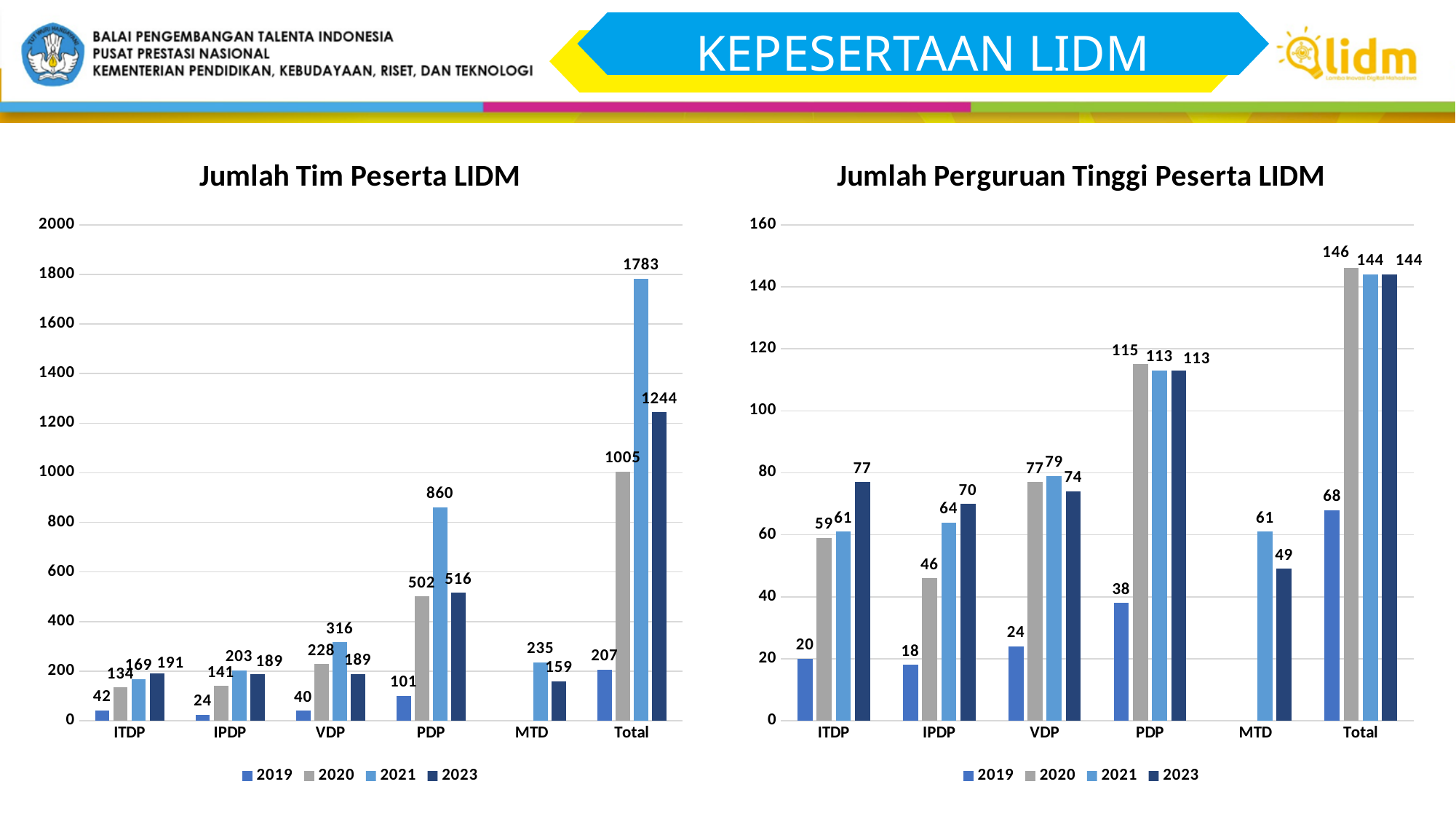
In the chart titled "Jumlah Tim Peserta LIDM", how many series does the legend list? 4 In the chart titled "Jumlah Perguruan Tinggi Peserta LIDM", how many categories are shown on the x axis? 6 In the chart titled "Jumlah Perguruan Tinggi Peserta LIDM", which is larger for VDP: the 2020 value or the 2023 value? 2020 In the chart titled "Jumlah Tim Peserta LIDM", what is the difference between the 2021 and 2020 values for Total? 778 In the chart titled "Jumlah Perguruan Tinggi Peserta LIDM", which category has the highest value for 2019? Total In the chart titled "Jumlah Tim Peserta LIDM", which category has the lowest value for 2019? IPDP In the chart titled "Jumlah Tim Peserta LIDM", what is the value for Total in 2023? 1244 In the chart titled "Jumlah Tim Peserta LIDM", what is the value for PDP in 2021? 860 In the chart titled "Jumlah Perguruan Tinggi Peserta LIDM", what is the value for IPDP in 2023? 70 In the chart titled "Jumlah Perguruan Tinggi Peserta LIDM", what is the difference between the 2020 and 2019 values for PDP? 77 In the chart titled "Jumlah Tim Peserta LIDM", what kind of chart is it? Bar chart In the chart titled "Jumlah Perguruan Tinggi Peserta LIDM", what is the value for MTD in 2021? 61